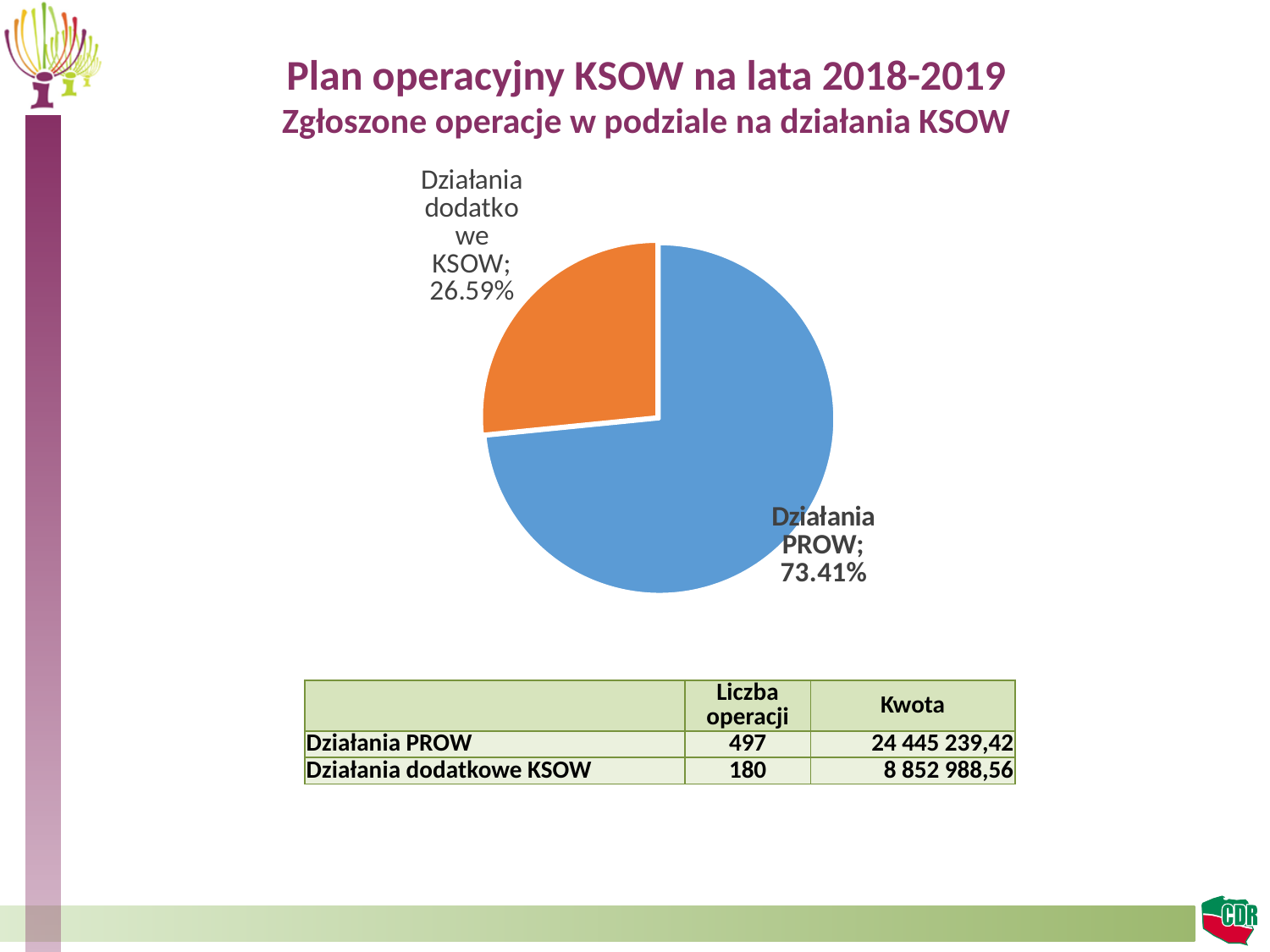
Which slice of the pie chart is the largest? Działania PROW What share of the pie does Działania dodatkowe KSOW represent? 26.59% How many slices does the pie chart have? 2 What kind of chart is shown on the slide? pie chart What share of the pie does Działania PROW represent? 73.41% Which is larger in the pie chart: Działania PROW or Działania dodatkowe KSOW? Działania PROW Which slice of the pie chart is the smallest? Działania dodatkowe KSOW By how many percentage points does the Działania PROW share exceed the Działania dodatkowe KSOW share? 46.82 What colour is the Działania PROW slice in the pie chart? blue What colour is the Działania dodatkowe KSOW slice in the pie chart? orange Is the share for Działania dodatkowe KSOW greater or less than 50%? less